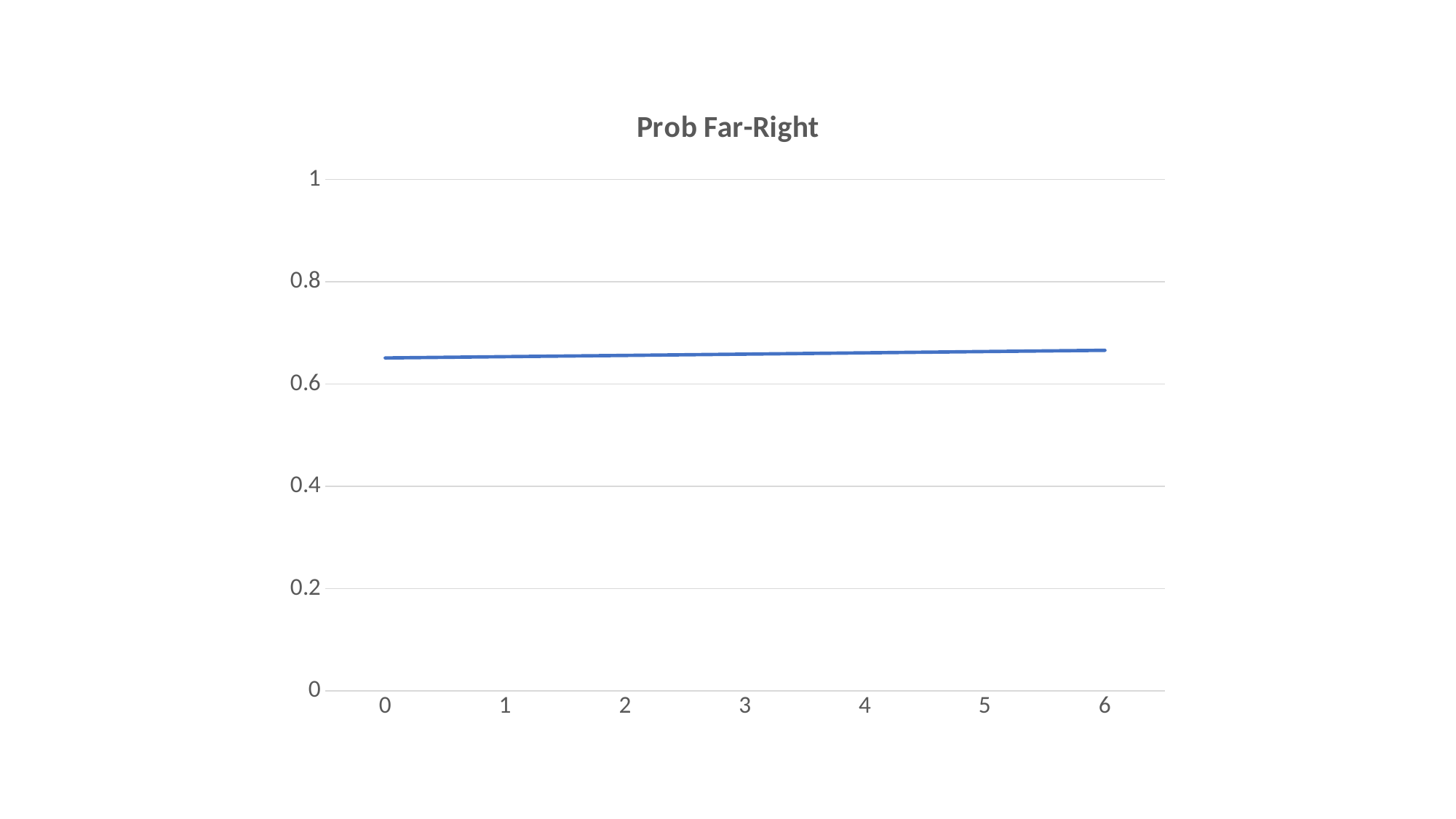
Does the line rise or fall as the x axis goes from 0 to 6? rise How many tick labels are shown on the x axis? 7 What is the highest value labelled on the y axis? 1 How many lines are plotted on the chart? 1 Is the value of the line at x = 6 greater or less than 0.8? less What is the title of the chart? Prob Far-Right Is the value of the line at x = 3 greater or less than 0.4? greater Is the value of the line at x = 0 greater or less than 0.6? greater What kind of chart is shown on the slide? line chart Which is larger, the value of the line at x = 0 or at x = 6? x = 6